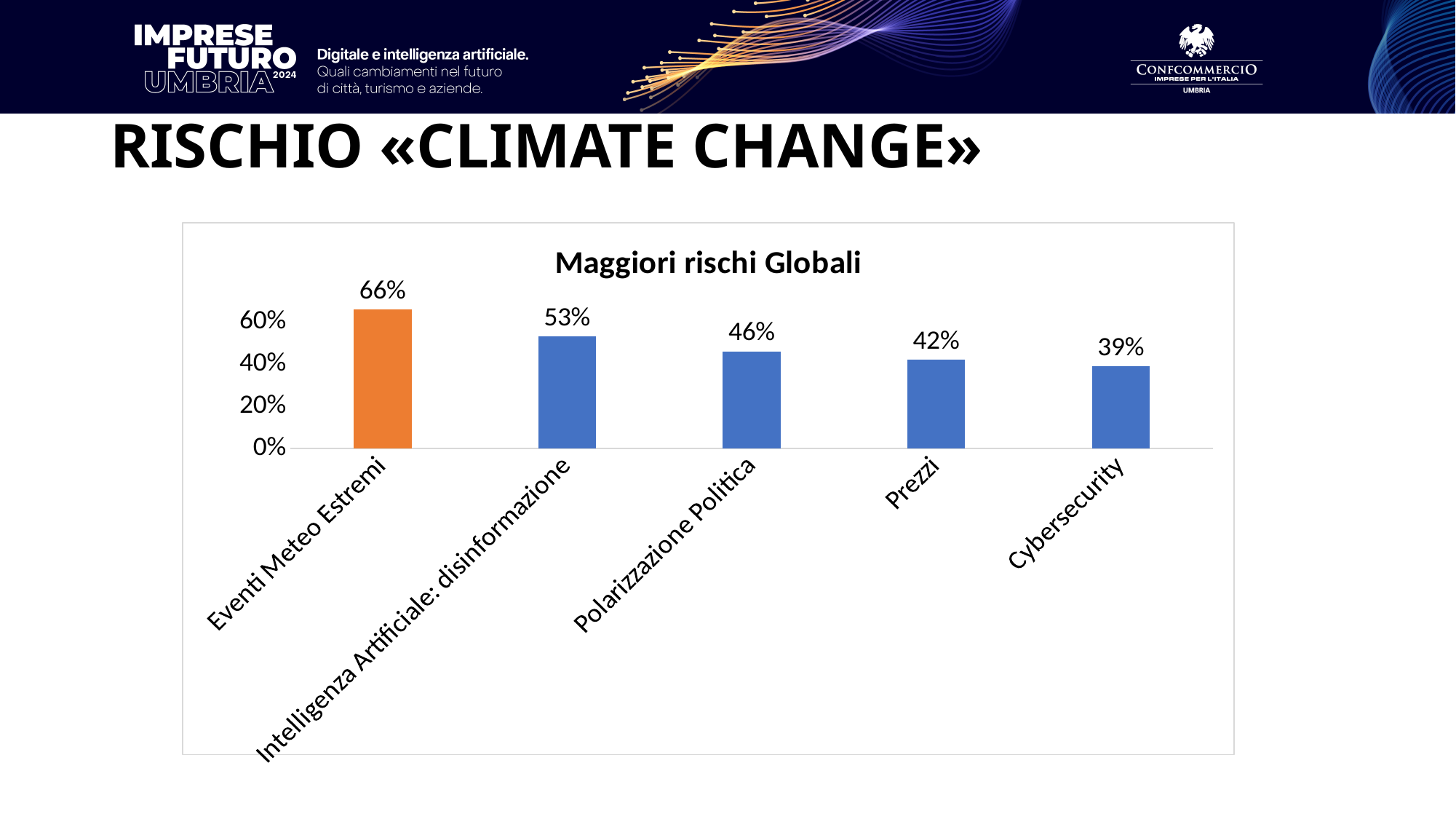
What is the value for Prezzi? 42% What is the value for Polarizzazione Politica? 46% What is the title of the chart? Maggiori rischi Globali Which category has the highest value? Eventi Meteo Estremi What is the value for Intelligenza Artificiale: disinformazione? 53% What kind of chart is shown on the slide? Bar chart How many categories are shown in the chart? 5 What is the difference between the values for Eventi Meteo Estremi and Cybersecurity? 27% Which is larger, the value for Polarizzazione Politica or the value for Prezzi? Polarizzazione Politica What is the value for Cybersecurity? 39% What is the value for Eventi Meteo Estremi? 66% Which category has the lowest value? Cybersecurity